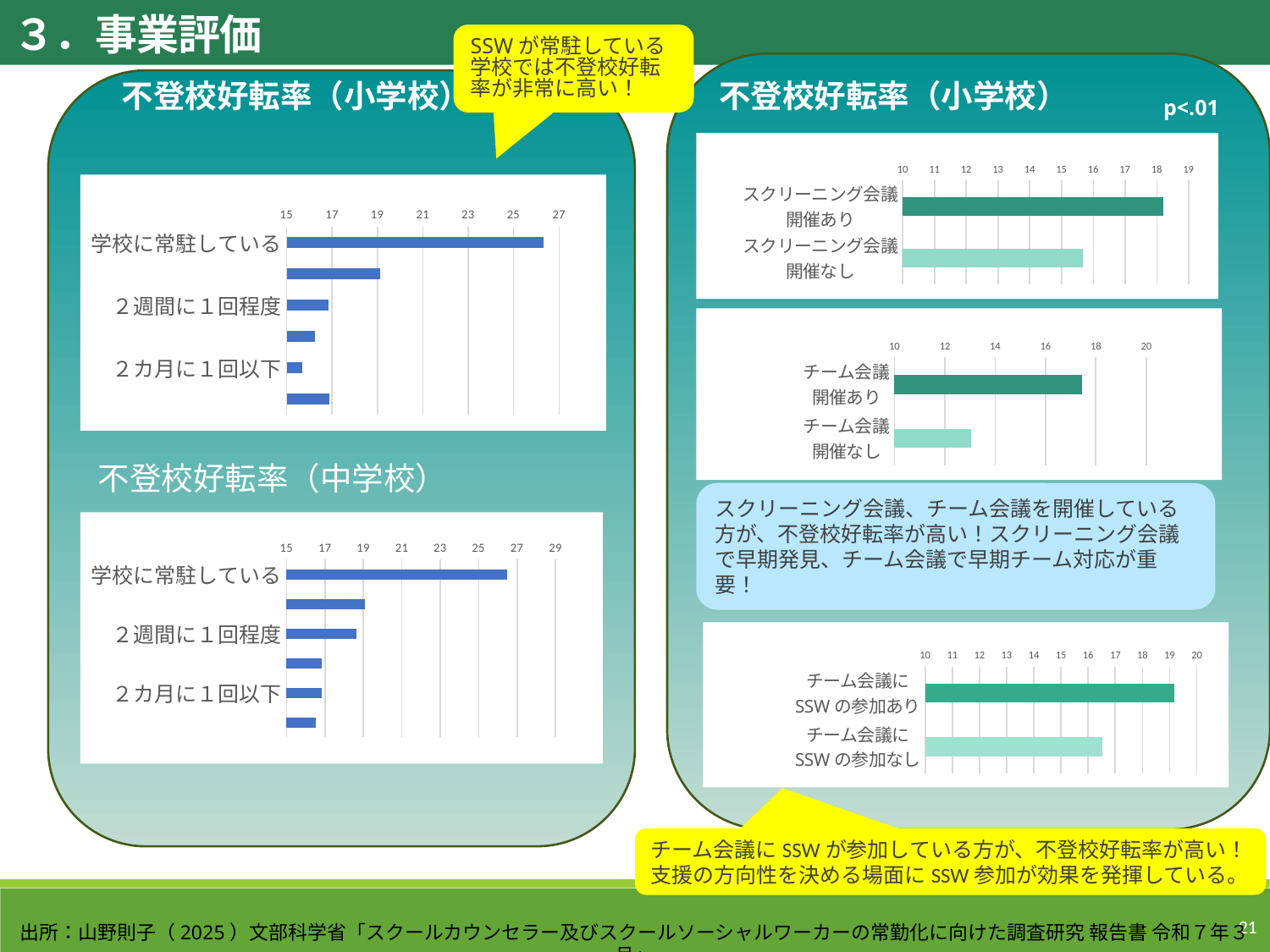
In the middle-right chart comparing チーム会議 開催あり and 開催なし, is the value for チーム会議 開催なし greater or less than 14? less In the 不登校好転率（小学校） chart on the left, which labeled category has the highest value? 学校に常駐している In the 不登校好転率（中学校） chart, is the value for 学校に常駐している greater or less than 25? greater In the top-right chart comparing スクリーニング会議 開催あり and 開催なし, which category has the higher value? スクリーニング会議 開催あり In the 不登校好転率（中学校） chart, which is larger, the value for 学校に常駐している or the value for 2カ月に1回以下? 学校に常駐している What kind of chart is the 不登校好転率（小学校） chart on the left side of the slide? bar chart What significance level is printed next to the title of the right-hand 不登校好転率（小学校） panel? p<.01 In the bottom-right chart, is the value for チーム会議にSSWの参加あり greater or less than 18? greater